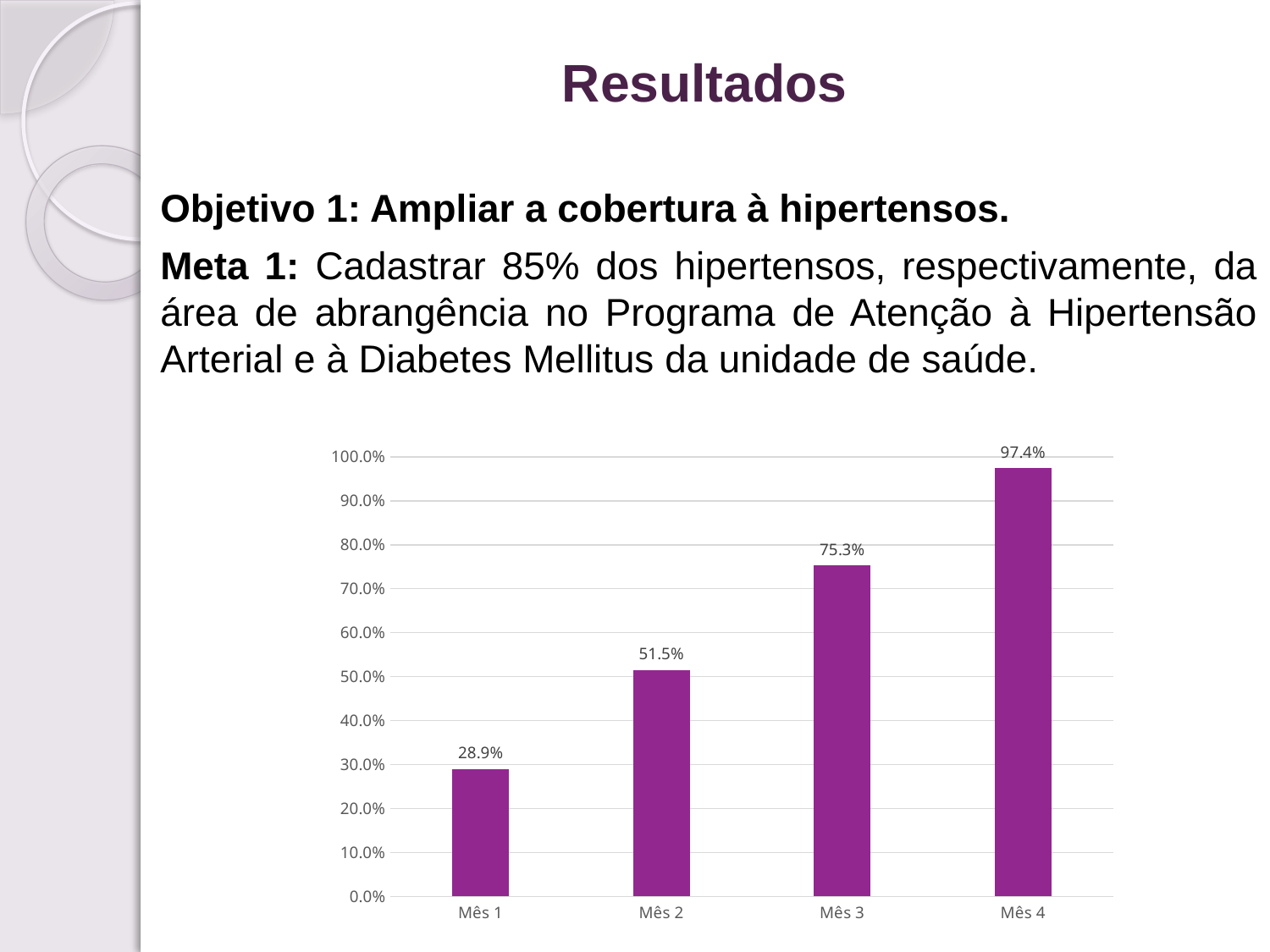
Is the value for Mês 2 greater or less than 50.0%? greater What is the difference between the values for Mês 4 and Mês 3? 22.1% Which month has the lowest value? Mês 1 What is the difference between the values for Mês 2 and Mês 1? 22.6% Do the values rise or fall from Mês 1 to Mês 4? rise What kind of chart is shown on the slide? bar chart What is the value for Mês 4? 97.4% What is the value for Mês 1? 28.9% Which is larger, the value for Mês 2 or the value for Mês 3? Mês 3 What is the value for Mês 3? 75.3% Which month has the highest value? Mês 4 How many months are shown on the x axis? 4